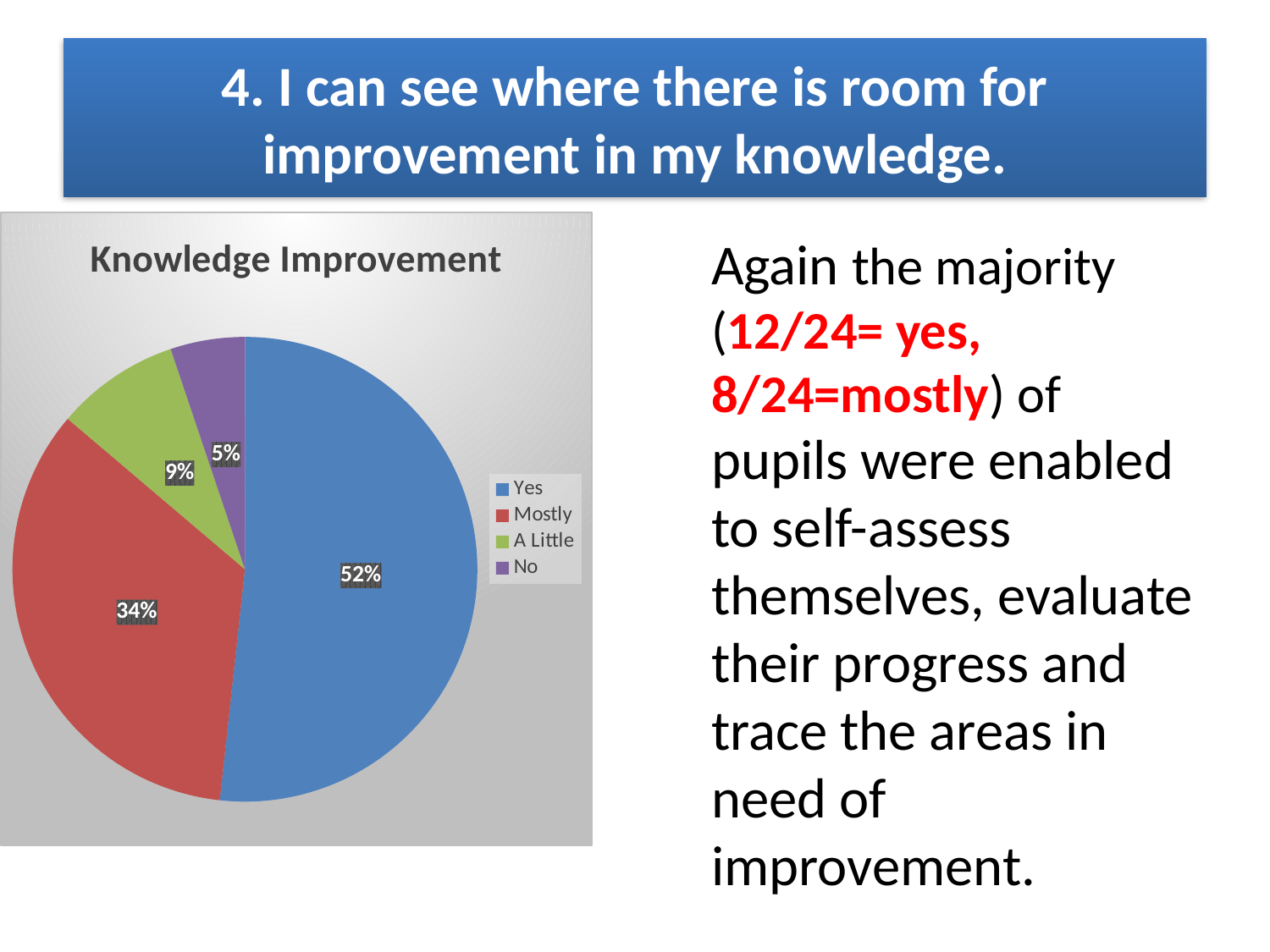
Which category has the largest share of the pie? Yes How many categories does the legend list? 4 What percentage of the pie is the "A Little" slice? 9% What type of chart is shown on the slide? pie chart What percentage of the pie is the "No" slice? 5% What colour is the "Mostly" slice? red What percentage of the pie is the "Mostly" slice? 34% What percentage of the pie is the "Yes" slice? 52% Which category has the smallest share of the pie? No What is the difference in percentage points between the "Yes" and "Mostly" slices? 18 What is the title of the chart? Knowledge Improvement Which slice is larger, "A Little" or "No"? A Little